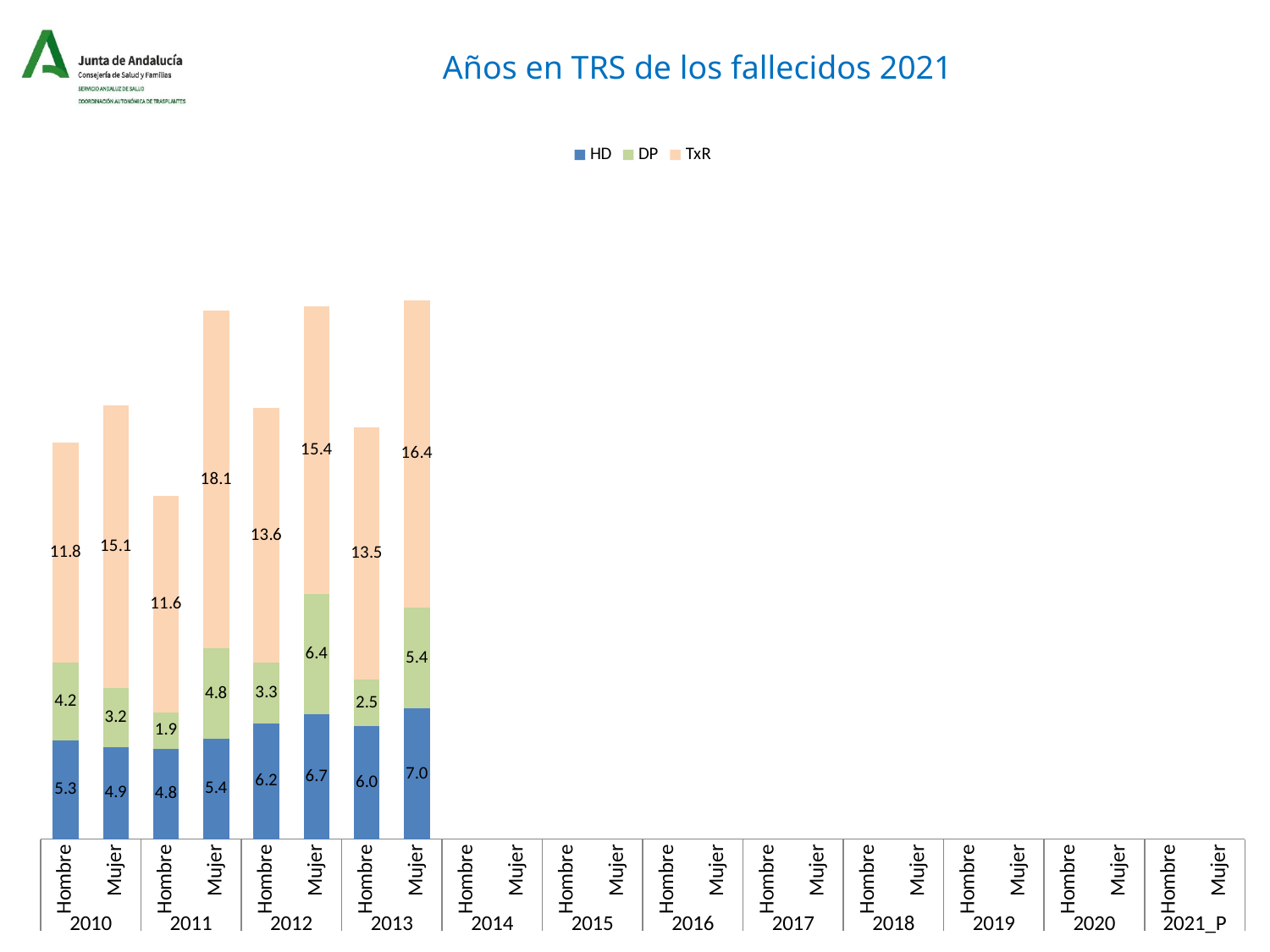
What is the total of the stacked bar for Mujer 2011? 28.3 What is the total of the stacked bar for Hombre 2010? 21.3 Which is larger, the HD value for Mujer 2012 or the HD value for Hombre 2012? Mujer 2012 What is the HD value for Hombre in 2010? 5.3 Which category has the lowest DP value? Hombre 2011 Which category has the highest TxR value? Mujer 2011 What is the DP value for Mujer in 2012? 6.4 How many series does the legend list? 3 What kind of chart is shown on the slide? Stacked bar chart What is the difference between the TxR values for Mujer 2013 and Hombre 2013? 2.9 What is the TxR value for Mujer in 2011? 18.1 What is the title of the chart? Años en TRS de los fallecidos 2021